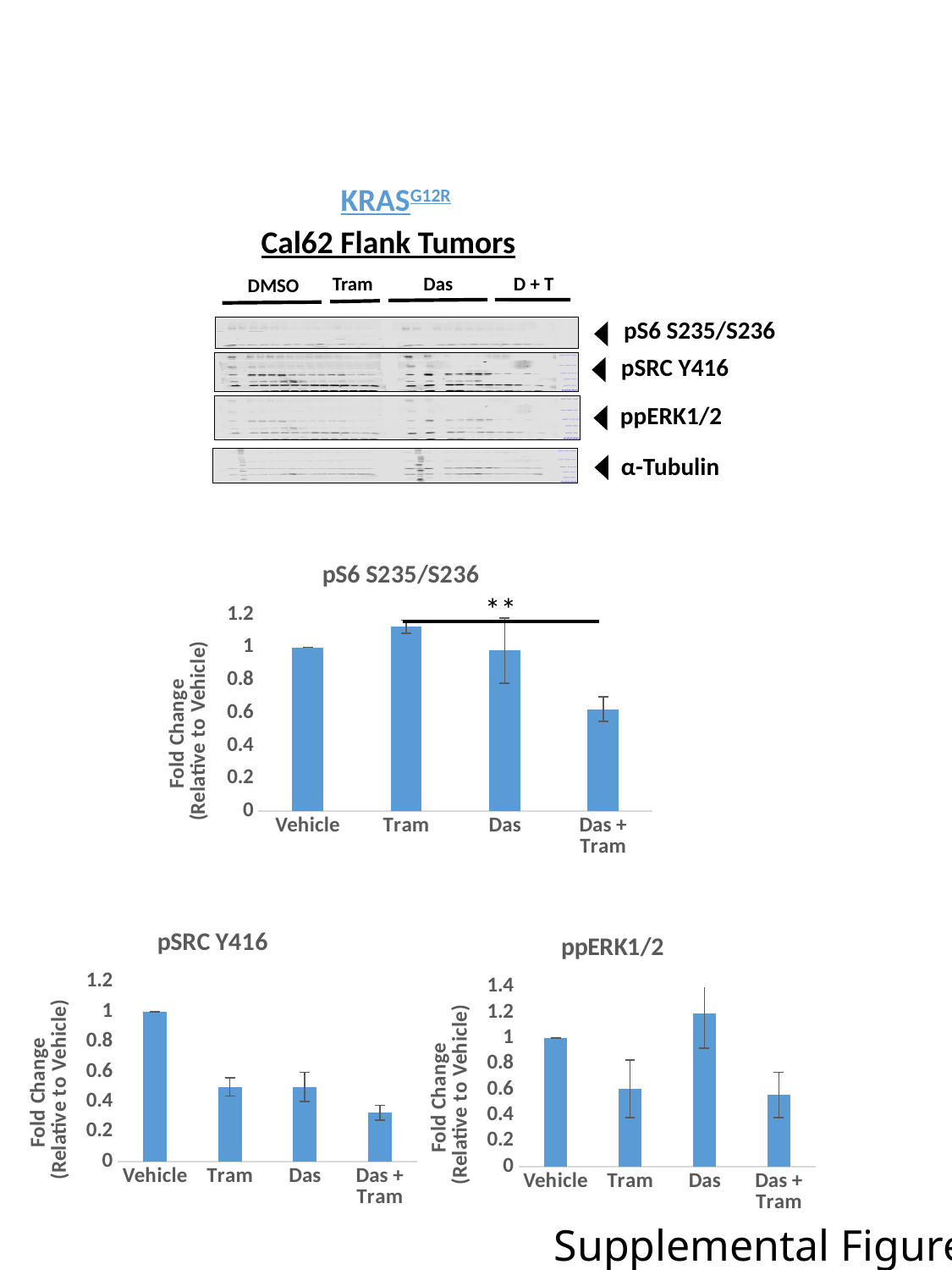
In the pS6 S235/S236 chart, what is the value for Vehicle? 1 How many categories are shown on the x axis of the pSRC Y416 chart? 4 In the pSRC Y416 chart, which category has the lowest value? Das + Tram In the ppERK1/2 chart, which is larger, the value for Vehicle or the value for Tram? Vehicle What kind of chart is the ppERK1/2 chart? bar chart In the pSRC Y416 chart, which category has the highest value? Vehicle In the ppERK1/2 chart, is the value for Das greater or less than 1? greater In the pS6 S235/S236 chart, which category has the highest value? Tram In the pSRC Y416 chart, is the value for Tram greater or less than 0.6? less In the ppERK1/2 chart, which category has the highest value? Das In the pS6 S235/S236 chart, is the value for Das + Tram greater or less than 0.8? less In the pS6 S235/S236 chart, which category has the lowest value? Das + Tram